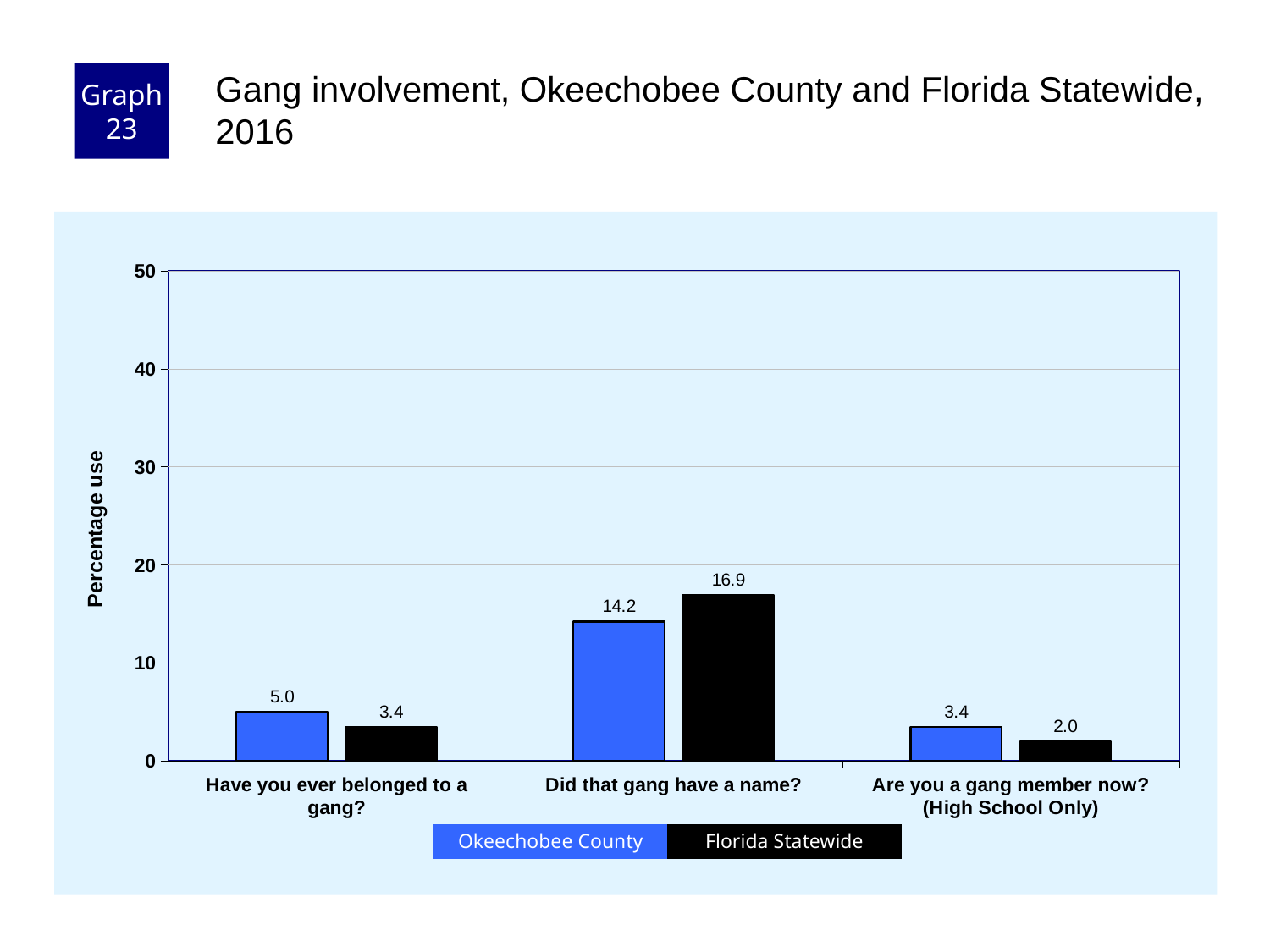
Which question has the lowest Florida Statewide value? Are you a gang member now? (High School Only) What is the difference between the Florida Statewide and Okeechobee County values for "Did that gang have a name?"? 2.7 What is the label of the y axis? Percentage use Which question has the highest Okeechobee County value? Did that gang have a name? What kind of chart is shown on the slide? bar chart How many question categories are shown on the x axis? 3 For "Have you ever belonged to a gang?", which is larger: Okeechobee County or Florida Statewide? Okeechobee County What is the Okeechobee County value for "Have you ever belonged to a gang?"? 5.0 What is the Florida Statewide value for "Are you a gang member now? (High School Only)"? 2.0 What is the Florida Statewide value for "Did that gang have a name?"? 16.9 How many series does the legend list? 2 Is the Florida Statewide value for "Did that gang have a name?" greater or less than 20? less